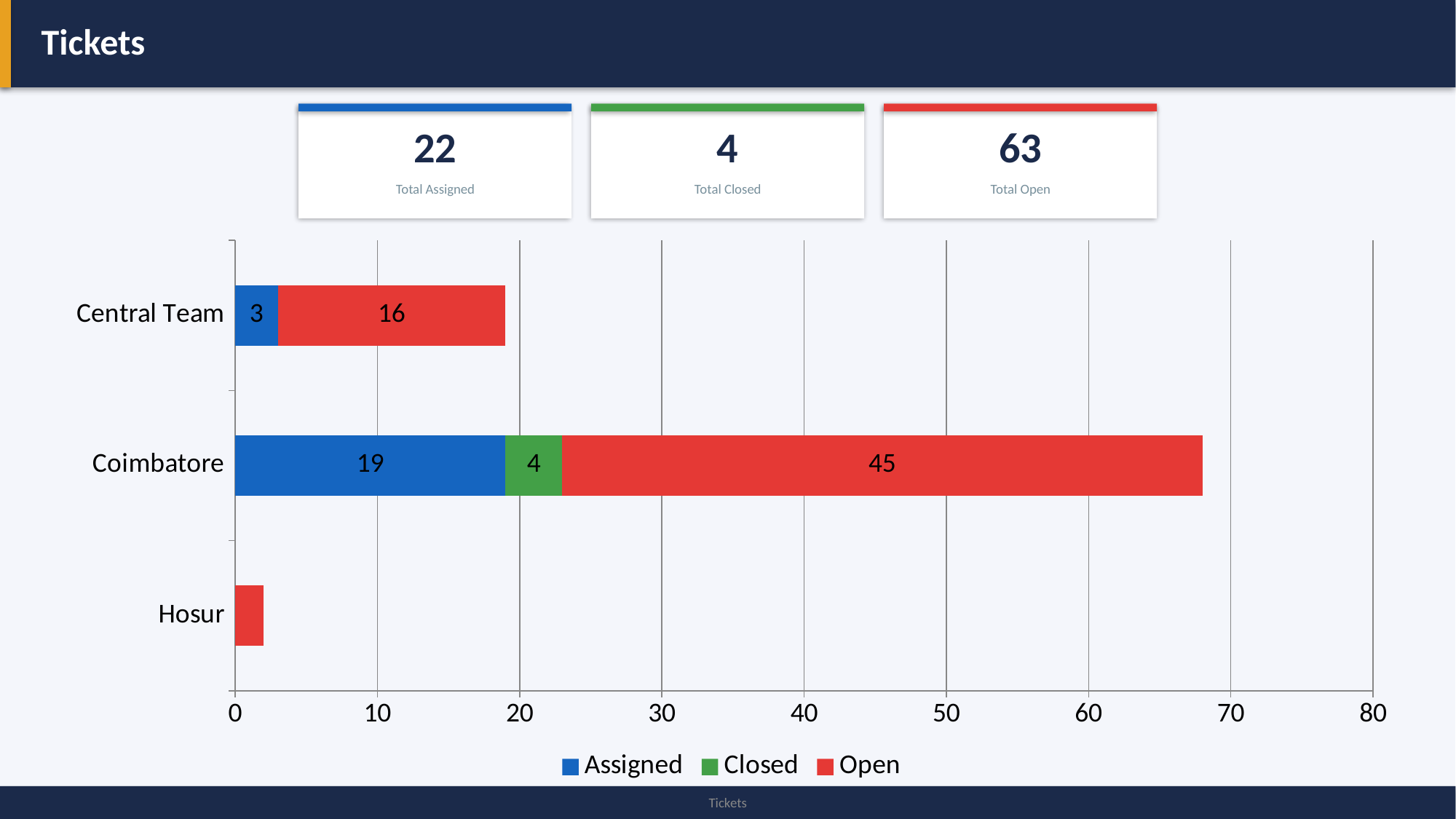
How many categories are shown on the y axis of the chart? 3 What is the Open value for Central Team? 16 Is the Open value for Hosur greater or less than 10? less What is the Assigned value for Central Team? 3 What is the total of the stacked bar for Coimbatore? 68 What kind of chart is shown on the slide? stacked bar chart Which has a larger Assigned value, Coimbatore or Central Team? Coimbatore What is the Closed value for Coimbatore? 4 What is the difference between the Open value for Coimbatore and the Open value for Central Team? 29 How many series does the legend list? 3 What is the Open value for Coimbatore? 45 Which category has the highest Open value? Coimbatore